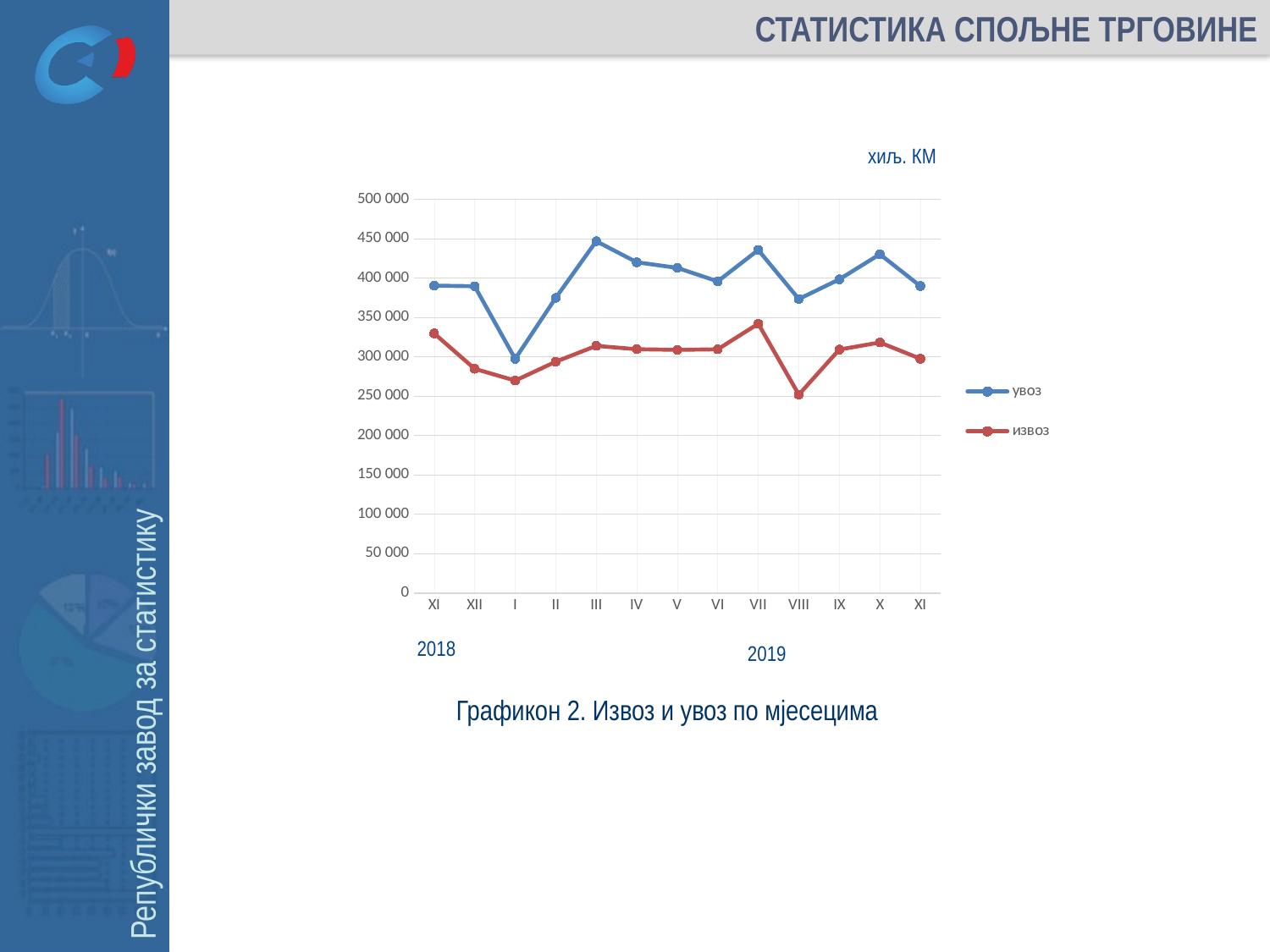
In which month is the value for увоз lowest? I Is the value for извоз in month VIII greater or less than 300 000? less Which is larger in month VII, увоз or извоз? увоз Does the value for увоз rise or fall from month XII to month I? fall Which series is plotted in red? извоз What kind of chart is shown on the slide? line chart What unit is indicated above the chart? хиљ. КМ Is the value for увоз in month III greater or less than 400 000? greater In which month is the value for извоз lowest? VIII In which month is the value for извоз highest? VII How many months (points) are plotted along the x axis? 13 How many series does the legend list? 2